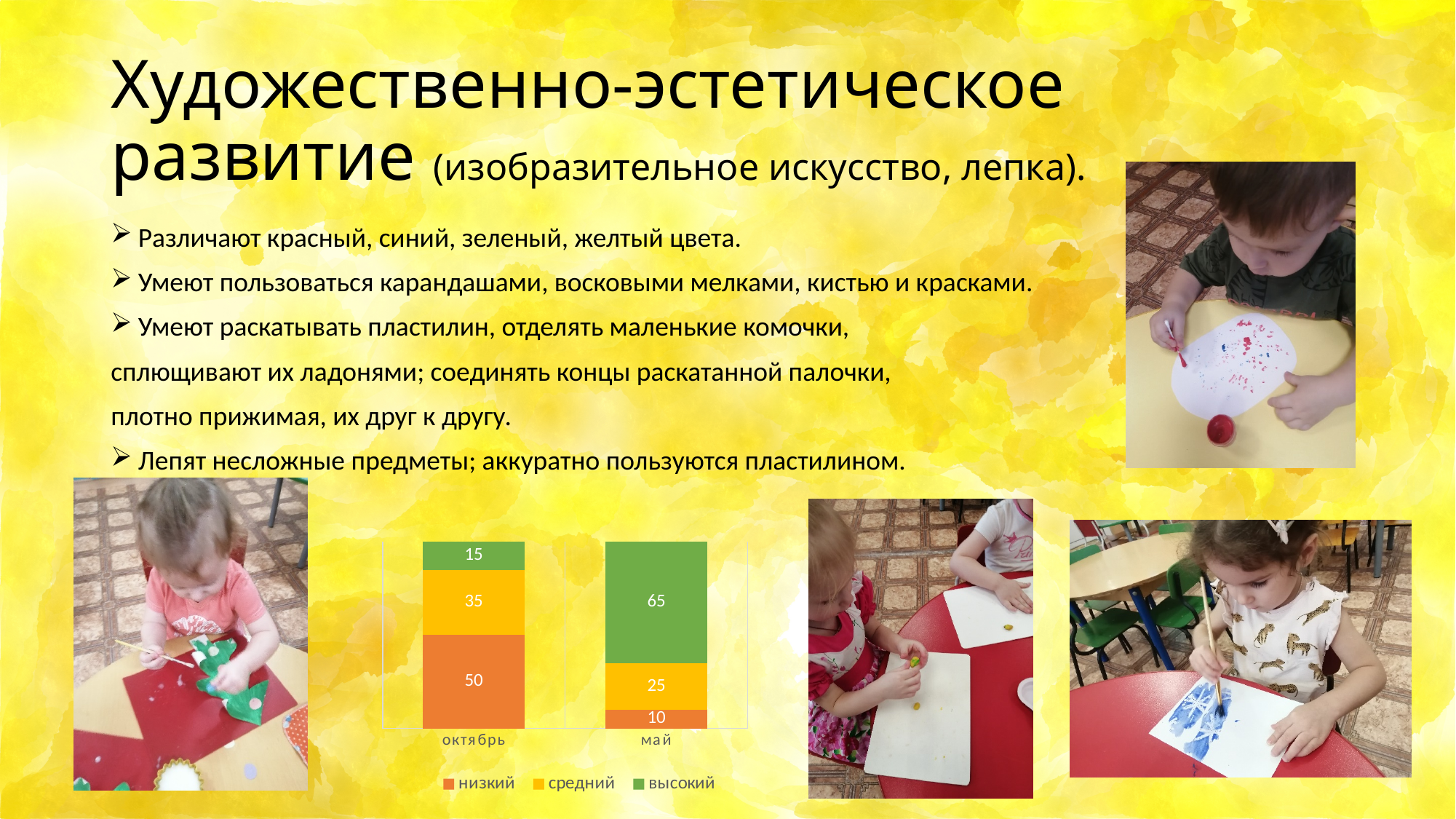
How many categories are shown on the x axis of the chart? 2 What is the difference between the низкий values for октябрь and май? 40 How many series does the chart legend list? 3 Does the высокий value rise or fall from октябрь to май? rise What kind of chart is shown on the slide? stacked bar chart Which colour represents the series низкий in the chart? orange What is the value of низкий for октябрь? 50 What is the value of высокий for май? 65 Which is larger: средний for октябрь or средний for май? октябрь What is the total of the stacked bar for май? 100 What is the value of высокий for октябрь? 15 What is the value of средний for май? 25